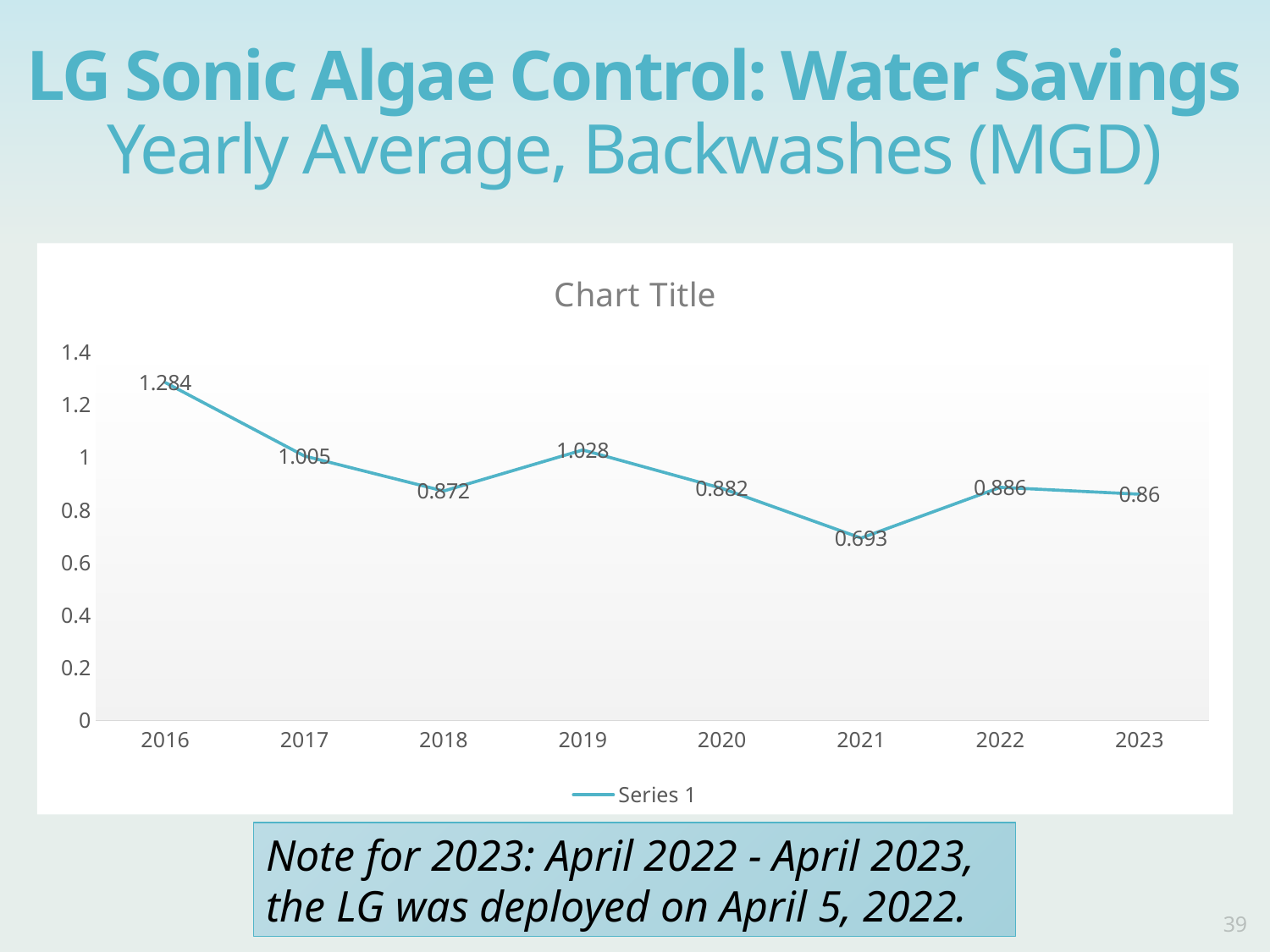
Which year has the lowest value? 2021 How many years are plotted on the x axis? 8 Which is larger, the value for 2018 or the value for 2019? 2019 Is the value for 2020 greater or less than 1? less What is the name of the series shown in the legend? Series 1 What is the value for 2016? 1.284 What is the difference between the values for 2019 and 2021? 0.335 Which year has the highest value? 2016 What is the value for 2021? 0.693 What is the value for 2023? 0.86 What kind of chart is shown? line chart What is the difference between the values for 2016 and 2017? 0.279